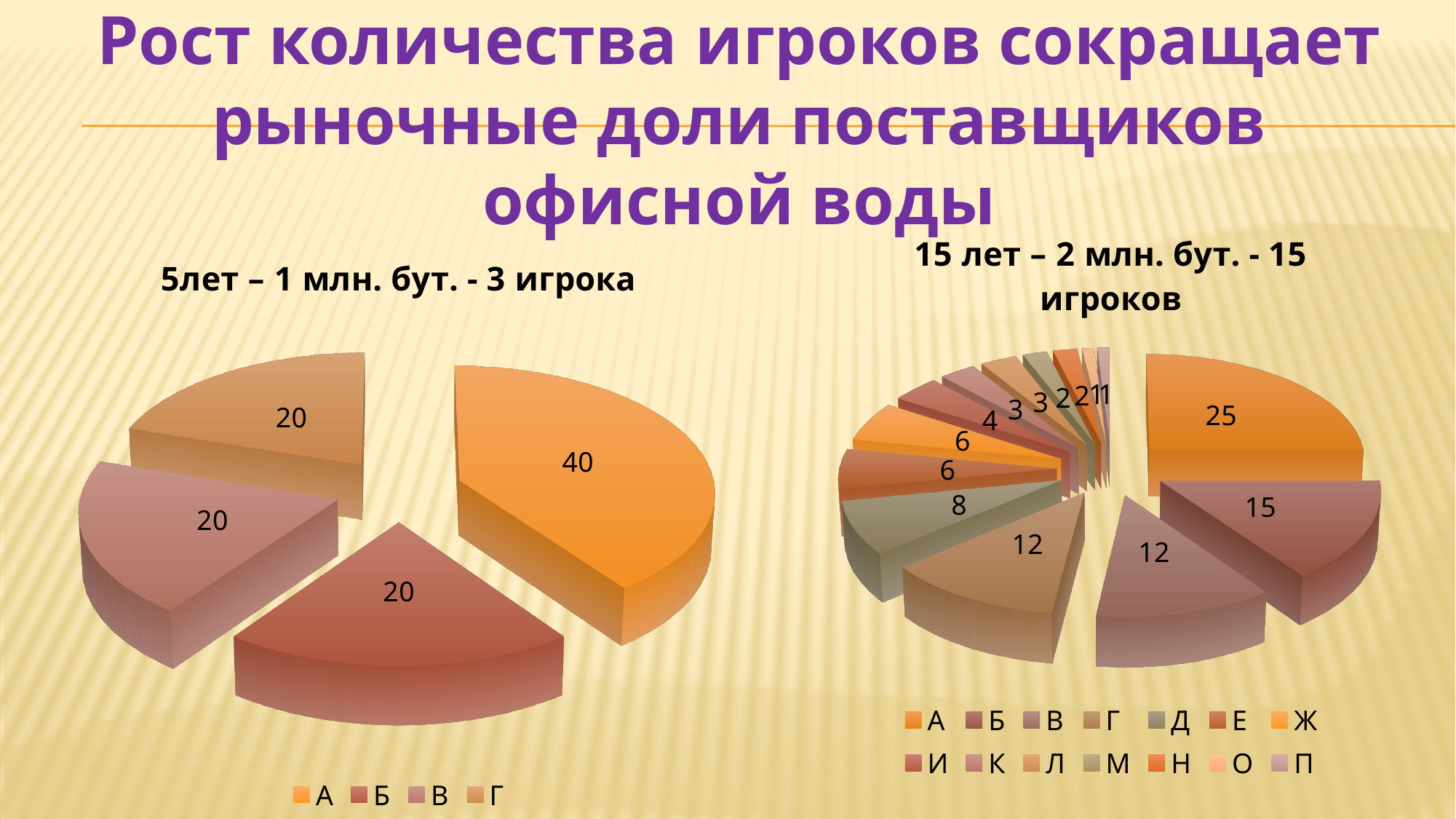
How many entries does the legend of the left chart ("5лет – 1 млн. бут. - 3 игрока") list? 4 In the right chart ("15 лет – 2 млн. бут. - 15 игроков"), what is the value for category А? 25 In the right chart ("15 лет – 2 млн. бут. - 15 игроков"), what is the value for category Б? 15 In the left chart ("5лет – 1 млн. бут. - 3 игрока"), what is the value for category А? 40 In the left chart ("5лет – 1 млн. бут. - 3 игрока"), what is the difference between the value for А and the value for Б? 20 In the right chart ("15 лет – 2 млн. бут. - 15 игроков"), which category has the largest slice? А In the left chart ("5лет – 1 млн. бут. - 3 игрока"), what is the value of the largest slice? 40 In the right chart ("15 лет – 2 млн. бут. - 15 игроков"), what is the value for category Д? 8 How many entries does the legend of the right chart ("15 лет – 2 млн. бут. - 15 игроков") list? 14 In the right chart ("15 лет – 2 млн. бут. - 15 игроков"), what is the difference between the value for А and the value for Д? 17 What type of chart is used on the left side of the slide, titled "5лет – 1 млн. бут. - 3 игрока"? Pie chart In the right chart ("15 лет – 2 млн. бут. - 15 игроков"), which is larger: the value for А or the value for Б? А